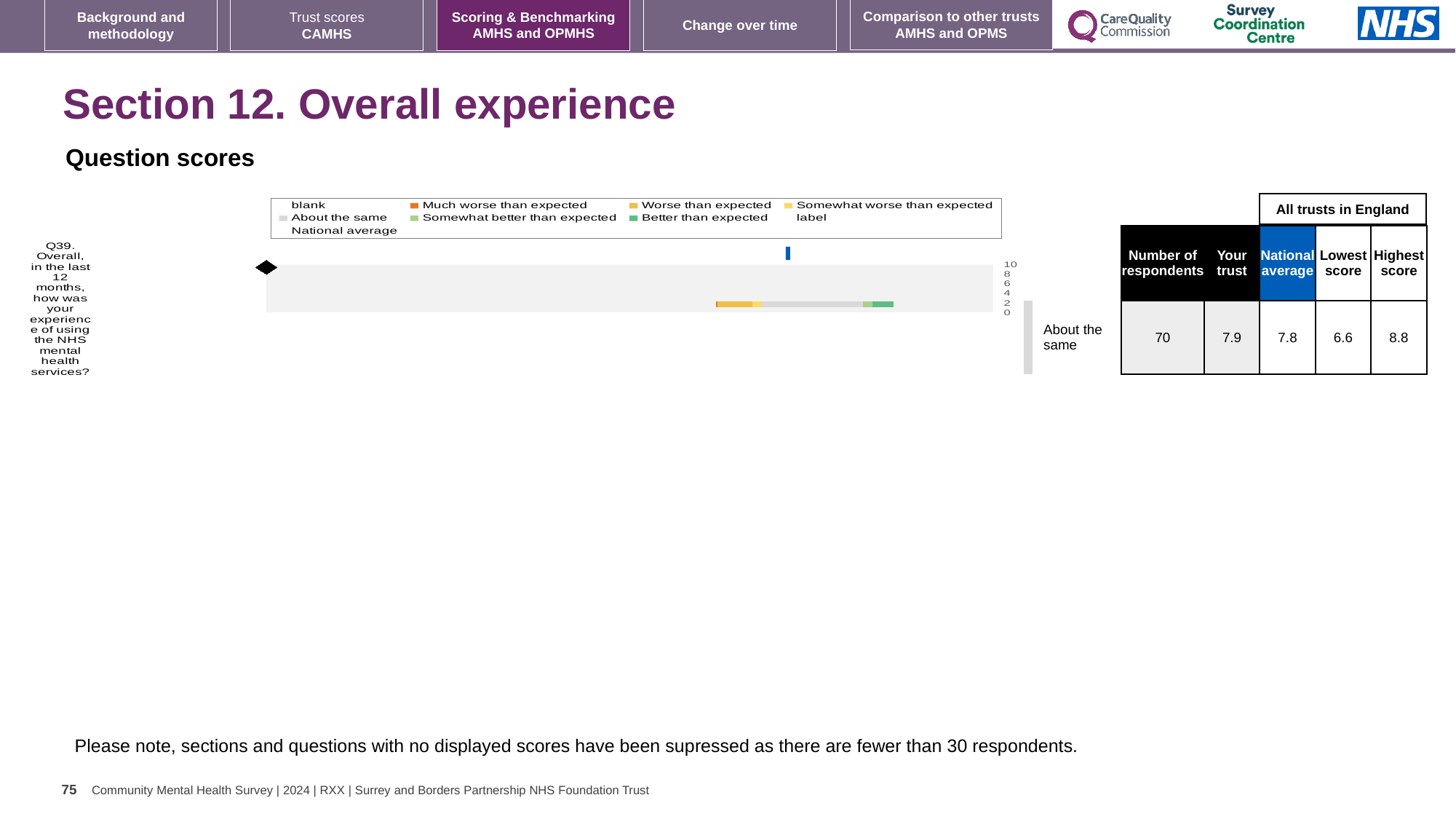
Which benchmark category is shown for Q39 (Overall experience of using NHS mental health services)? About the same What is the Lowest score among all trusts in England for Q39? 6.6 What is the Highest score among all trusts in England for Q39? 8.8 How many questions are plotted in the Question scores chart? 1 What is the difference between the Highest score and the Lowest score for Q39? 2.2 How many respondents answered Q39? 70 What is the highest value shown on the chart's score axis? 10 What is the National average score for Q39? 7.8 What is the 'Your trust' score for Q39? 7.9 What colour represents 'Better than expected' in the chart legend? green For Q39, which is larger: the 'Your trust' score or the National average? Your trust What kind of chart is used to show the Q39 question score? bar chart